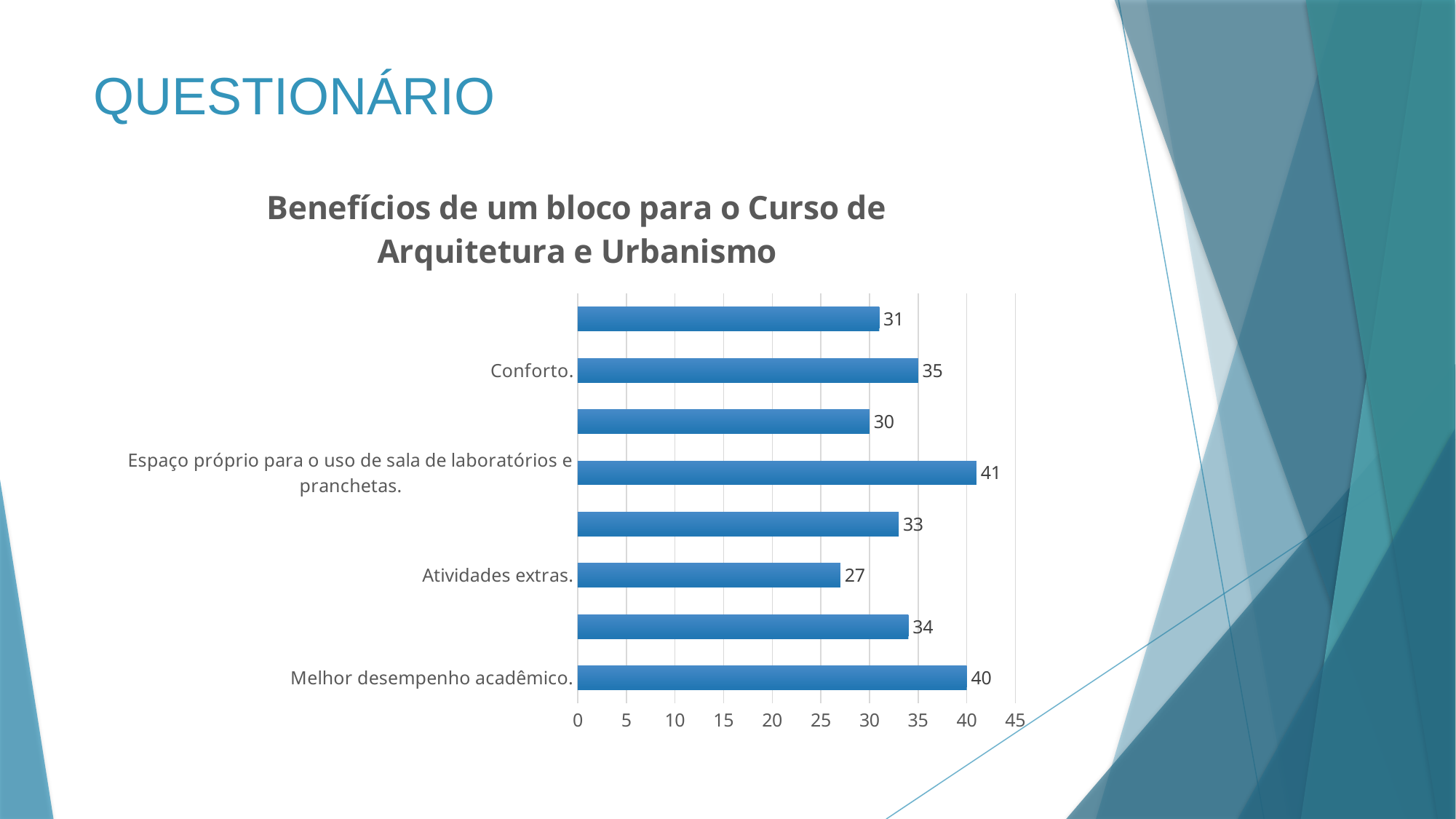
What is the value for "Conforto."? 35 What is the value for "Melhor desempenho acadêmico."? 40 What is the difference between the values for "Espaço próprio para o uso de sala de laboratórios e pranchetas." and "Atividades extras."? 14 What is the difference between the values for "Melhor desempenho acadêmico." and "Conforto."? 5 What kind of chart is shown on the slide? bar chart Which category has the highest value? Espaço próprio para o uso de sala de laboratórios e pranchetas. Which category has the lowest value? Atividades extras. What is the value for "Atividades extras."? 27 Which is larger, the value for "Conforto." or the value for "Melhor desempenho acadêmico."? Melhor desempenho acadêmico. How many bars are plotted in the chart? 8 What is the value for "Espaço próprio para o uso de sala de laboratórios e pranchetas."? 41 Is the value for "Atividades extras." greater or less than 30? less